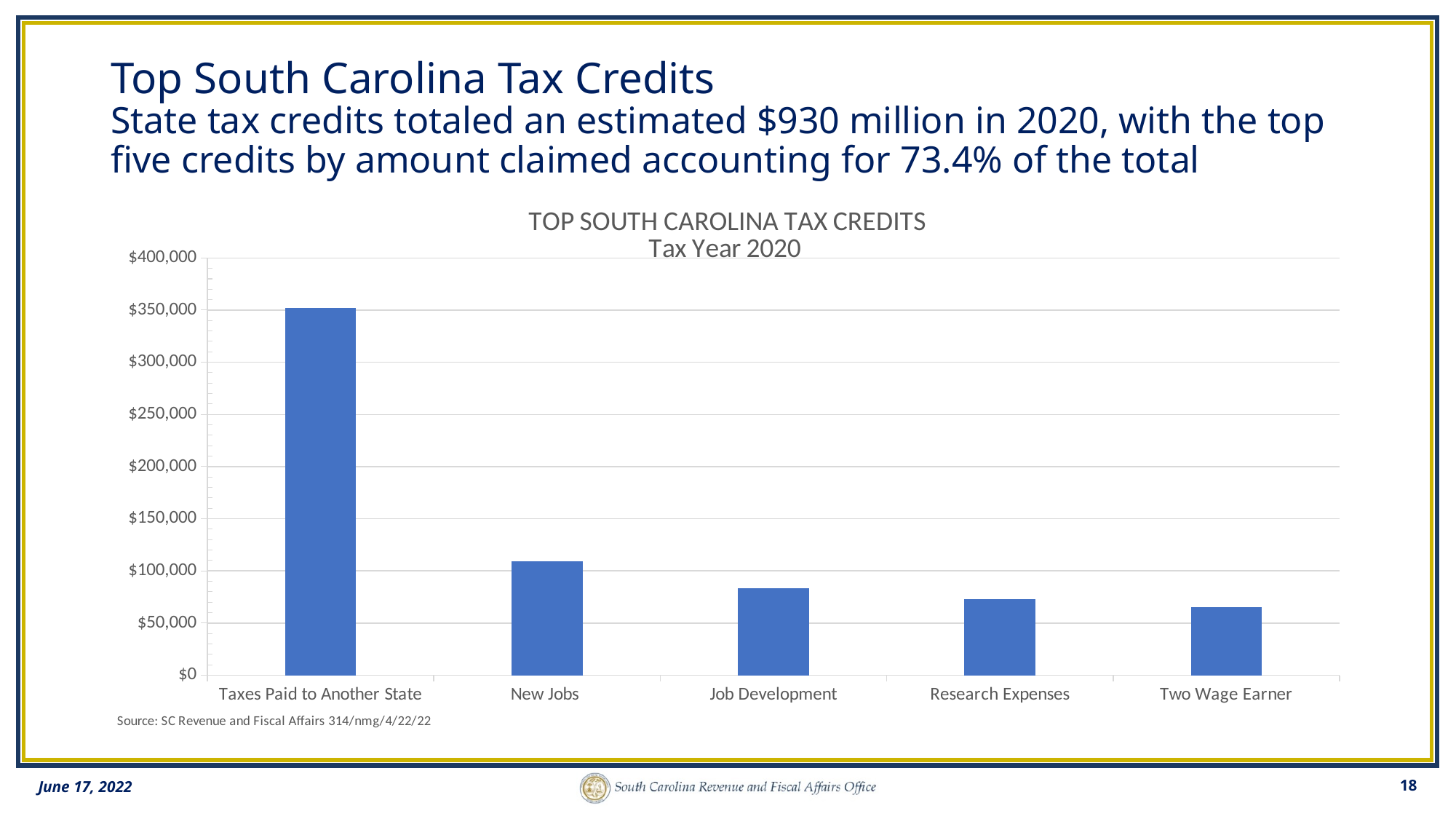
Is the value for Two Wage Earner greater or less than $50,000? greater Which tax credit has the lowest value in the chart? Two Wage Earner Which tax credit has the highest value in the chart? Taxes Paid to Another State How many tax credit categories are plotted in the chart? 5 Is the value for Taxes Paid to Another State greater or less than $300,000? greater Which is larger, the value for New Jobs or the value for Research Expenses? New Jobs What is the title of the chart? TOP SOUTH CAROLINA TAX CREDITS Tax Year 2020 Is the value for Job Development greater or less than $100,000? less Do the bar values rise or fall moving from left to right across the chart? fall What type of chart is shown on the slide? bar chart What is the maximum value shown on the vertical axis of the chart? $400,000